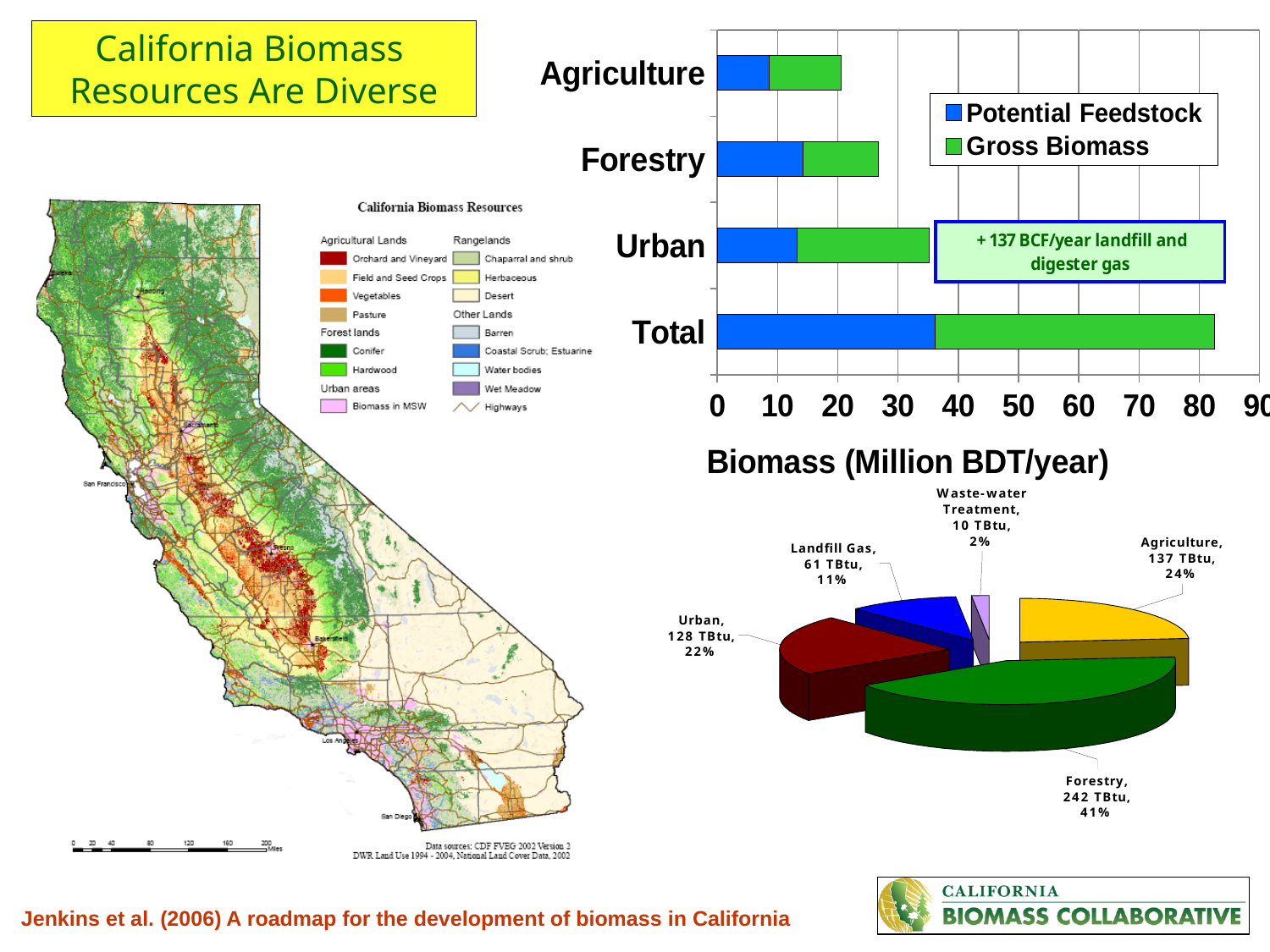
In the pie chart at the bottom right, what is the difference in TBtu between Forestry and Landfill Gas? 181 TBtu In the pie chart at the bottom right, what value is shown for Urban? 128 TBtu In the bar chart titled 'Biomass (Million BDT/year)', what are the two legend entries? Potential Feedstock and Gross Biomass In the bar chart titled 'Biomass (Million BDT/year)', is the total length of the Agriculture bar greater or less than 30? less In the bar chart titled 'Biomass (Million BDT/year)', is the total length of the Total bar greater or less than 70? greater In the bar chart titled 'Biomass (Million BDT/year)', which of the three sector categories (Agriculture, Forestry, Urban) has the longest bar? Urban What kind of chart is the chart titled 'Biomass (Million BDT/year)'? Stacked bar chart In the pie chart at the bottom right, which category has the smallest slice? Waste-water Treatment In the bar chart titled 'Biomass (Million BDT/year)', how many categories are shown on the vertical axis? 4 In the bar chart titled 'Biomass (Million BDT/year)', how many series does the legend list? 2 In the pie chart at the bottom right, which category has the largest slice? Forestry In the pie chart at the bottom right, what share of the pie does Agriculture represent? 24%